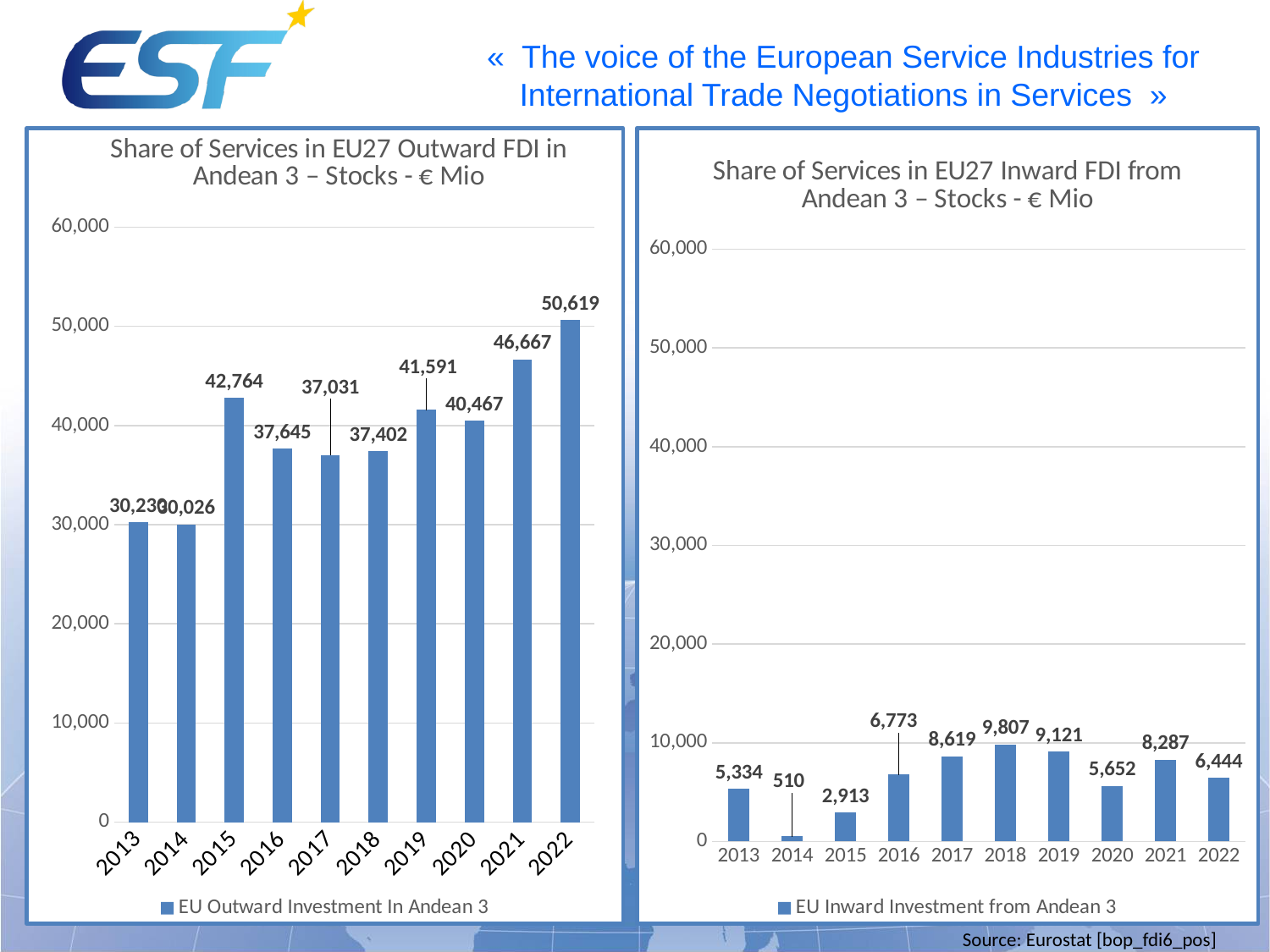
In the 'Share of Services in EU27 Outward FDI in Andean 3' chart, what is the difference between the 2022 and 2021 values? 3,952 What is the legend entry of the 'Share of Services in EU27 Inward FDI from Andean 3' chart? EU Inward Investment from Andean 3 In the 'Share of Services in EU27 Outward FDI in Andean 3' chart, what is the value for 2015? 42,764 What kind of chart is the 'Share of Services in EU27 Inward FDI from Andean 3' chart? bar chart In the 'Share of Services in EU27 Inward FDI from Andean 3' chart, which year has the lowest value? 2014 In the 'Share of Services in EU27 Outward FDI in Andean 3' chart, which year has the highest value? 2022 In the 'Share of Services in EU27 Outward FDI in Andean 3' chart, how many years are shown on the x axis? 10 In the 'Share of Services in EU27 Outward FDI in Andean 3' chart, what is the value for 2022? 50,619 In the 'Share of Services in EU27 Inward FDI from Andean 3' chart, what is the value for 2018? 9,807 In the 'Share of Services in EU27 Inward FDI from Andean 3' chart, what is the difference between the 2017 and 2016 values? 1,846 In the 'Share of Services in EU27 Outward FDI in Andean 3' chart, which is larger, the value for 2016 or the value for 2018? 2016 In the 'Share of Services in EU27 Inward FDI from Andean 3' chart, is the value for 2019 greater or less than 10,000? less